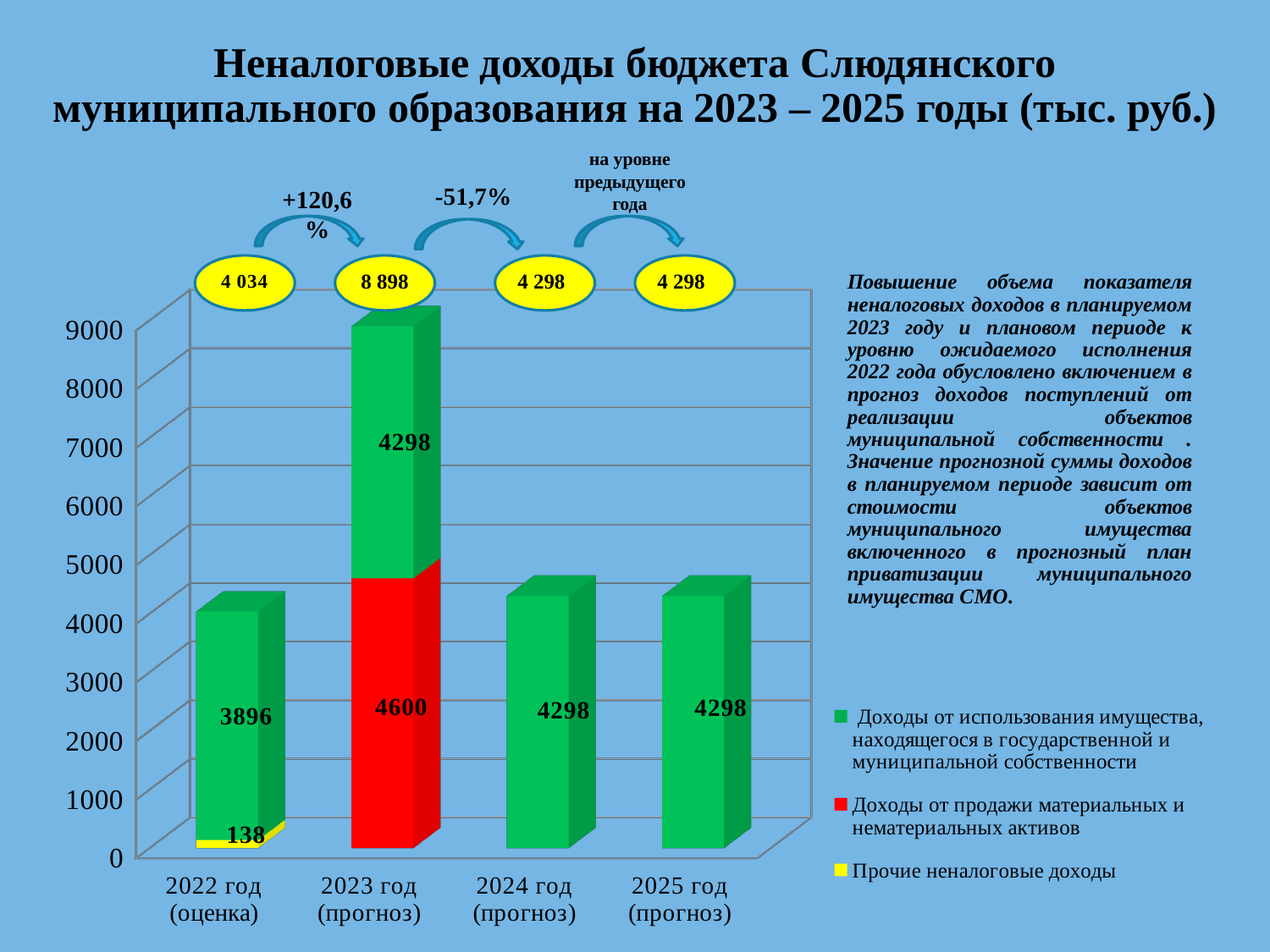
How many categories (years) are shown on the x axis of the chart? 4 What is the total shown above the bar for 2022 год (оценка)? 4 034 What is the value of 'Прочие неналоговые доходы' for 2022 год (оценка)? 138 What is the value of 'Доходы от использования имущества, находящегося в государственной и муниципальной собственности' for 2022 год (оценка)? 3896 What type of chart is shown on the slide? stacked bar chart Which year has the highest total non-tax revenue? 2023 год (прогноз) What is the difference between the 2023 total (8 898) and the 2024 total (4 298)? 4 600 What is the total shown above the bar for 2023 год (прогноз)? 8 898 What percentage change is shown between 2022 and 2023 above the chart? +120,6 % Which is larger: the green segment for 2022 год (оценка) or the green segment for 2024 год (прогноз)? 2024 год (прогноз) What is the value of 'Доходы от продажи материальных и нематериальных активов' for 2023 год (прогноз)? 4600 How many series does the chart legend list? 3